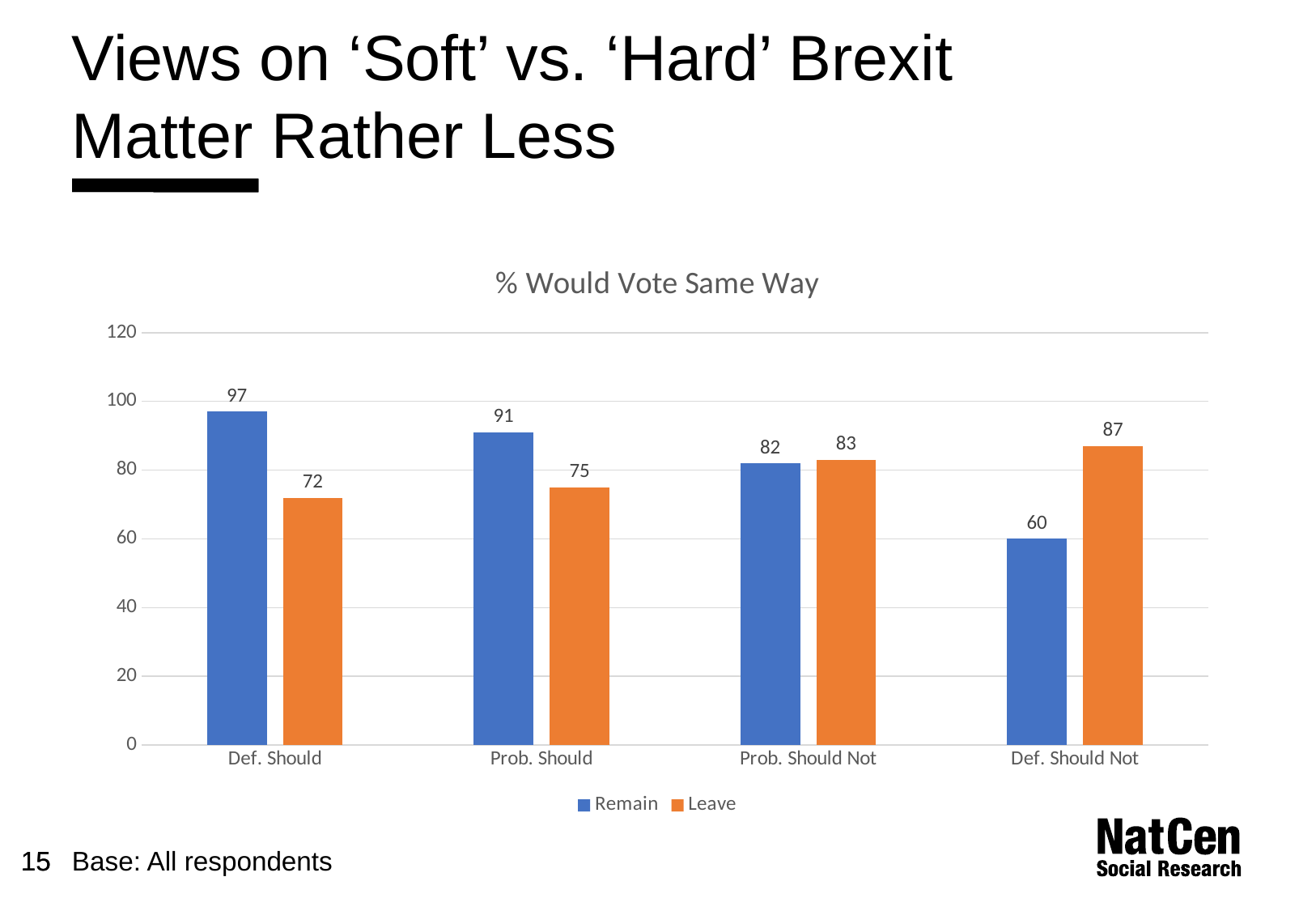
How many categories are shown on the x axis? 4 What is the Leave value for Prob. Should Not? 83 What is the Leave value for Def. Should Not? 87 Which category has the lowest Leave value? Def. Should For Prob. Should, which is larger, the Remain value or the Leave value? Remain Do the Remain values rise or fall from Def. Should to Def. Should Not? Fall What is the difference between the Remain and Leave values for Def. Should? 25 What is the difference between the Leave and Remain values for Def. Should Not? 27 How many series does the legend list? 2 Which category has the highest Remain value? Def. Should What is the Remain value for Def. Should? 97 What kind of chart is shown? Bar chart